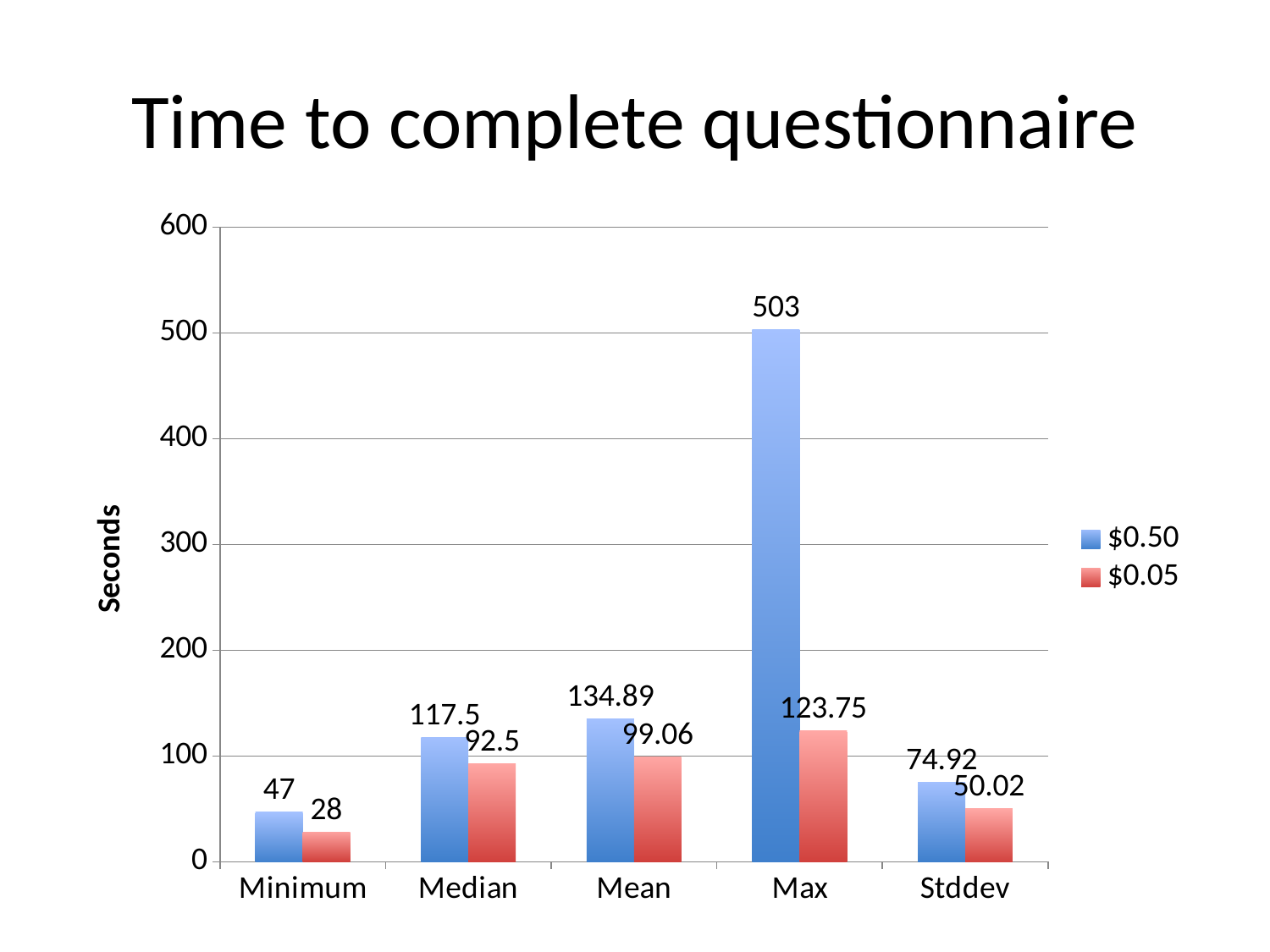
What is the difference between the $0.50 and $0.05 values at Max? 379.25 What is the value for the $0.50 series at Stddev? 74.92 What is the value for the $0.50 series at Max? 503 What is the value for the $0.05 series at Median? 92.5 What kind of chart is shown on the slide? bar chart What is the difference between the $0.50 and $0.05 values at Minimum? 19 Is the value for the $0.50 series at Max greater or less than 400? greater How many series does the legend list? 2 Which category has the highest value for the $0.05 series? Max How many categories are shown on the x axis? 5 Which category has the lowest value for the $0.50 series? Minimum Which is larger at Mean: the $0.50 value or the $0.05 value? $0.50